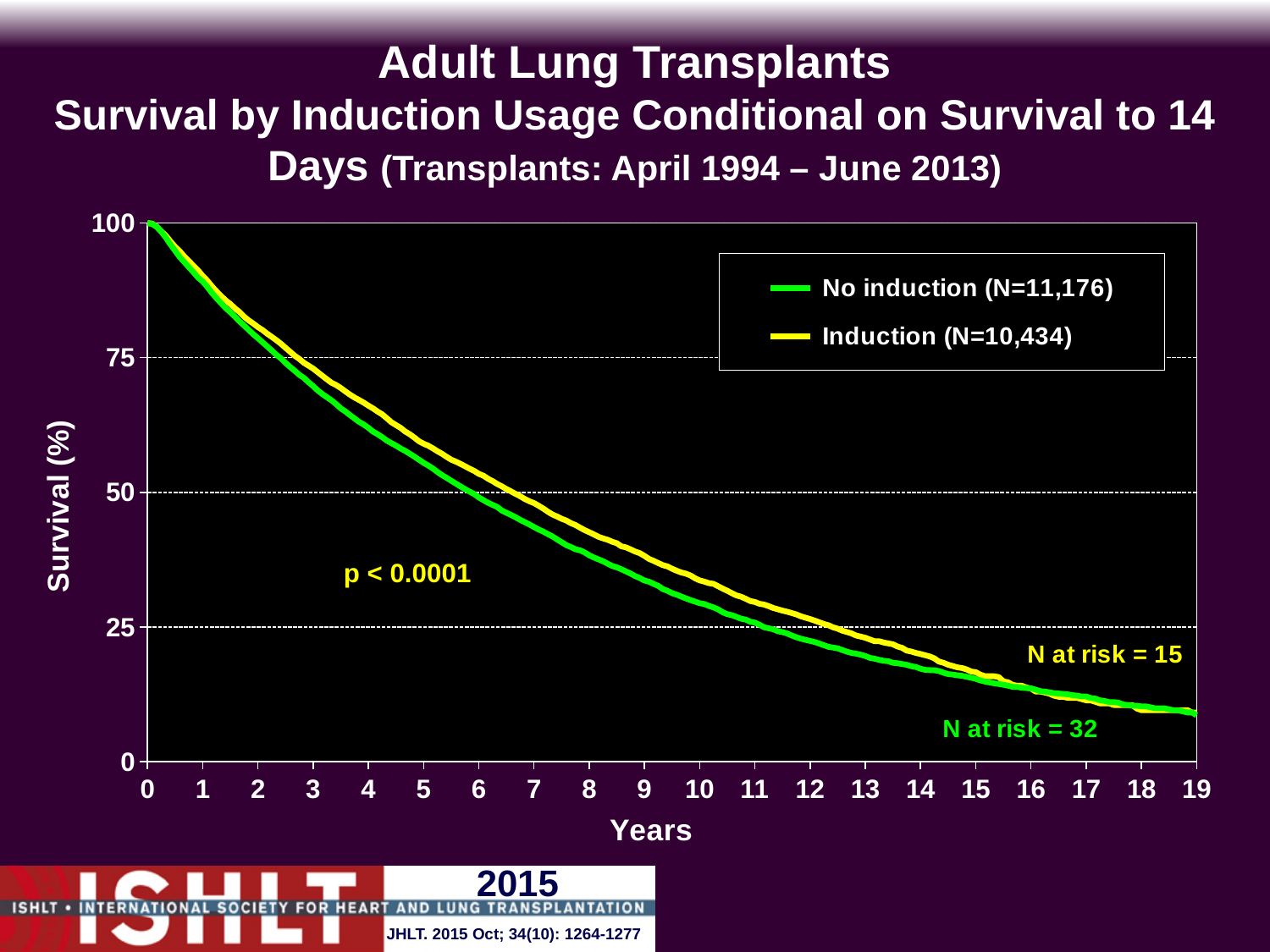
Is the survival value for the No induction group at 15 years greater or less than 25? less What kind of chart is shown on the slide? line chart What is the N at risk printed for the No induction (green) curve? 32 At 5 years, which group has the higher survival, Induction or No induction? Induction Is the survival value for the Induction group at 5 years greater or less than 50? greater Do the survival curves rise or fall as years increase? fall How many series does the legend list? 2 What p-value is printed on the chart? p < 0.0001 What is the N for the No induction group shown in the legend? 11,176 Which series is shown in yellow? Induction (N=10,434) What is the N at risk printed for the Induction (yellow) curve? 15 Is the survival value for the No induction group at 1 year greater or less than 75? greater